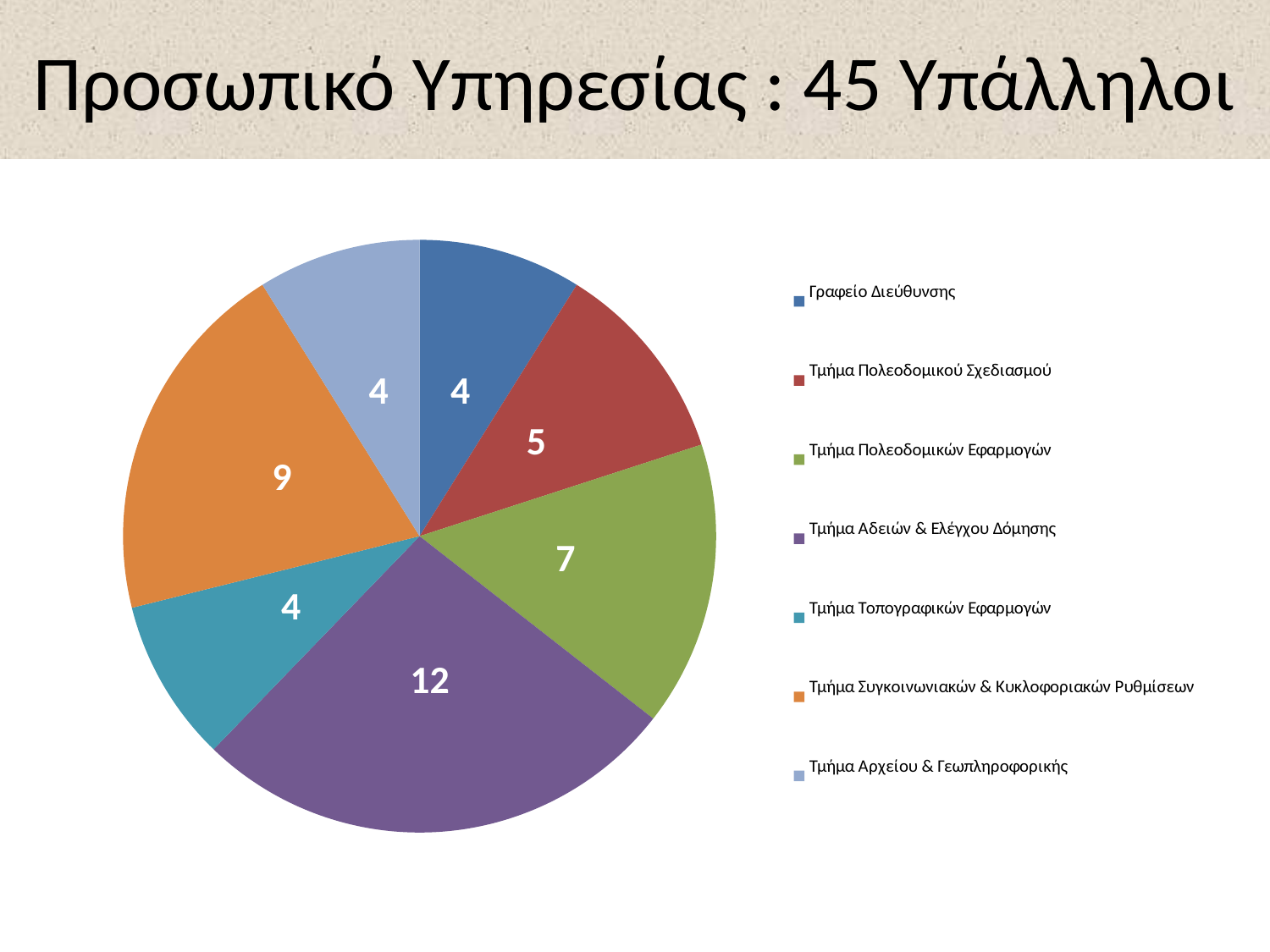
How many employees are in Τμήμα Αδειών & Ελέγχου Δόμησης? 12 What kind of chart is shown on the slide? pie chart What share of the 45 employees does Τμήμα Συγκοινωνιακών & Κυκλοφοριακών Ρυθμίσεων represent? 20% Which is larger, Τμήμα Πολεοδομικών Εφαρμογών or Τμήμα Πολεοδομικού Σχεδιασμού? Τμήμα Πολεοδομικών Εφαρμογών What is the value for Τμήμα Πολεοδομικού Σχεδιασμού? 5 Which department has the largest slice of the pie? Τμήμα Αδειών & Ελέγχου Δόμησης How many slices does the pie chart have? 7 What is the title of the slide? Προσωπικό Υπηρεσίας : 45 Υπάλληλοι What is the value for Τμήμα Συγκοινωνιακών & Κυκλοφοριακών Ρυθμίσεων? 9 What is the value for Γραφείο Διεύθυνσης? 4 What is the difference between Τμήμα Αδειών & Ελέγχου Δόμησης and Τμήμα Συγκοινωνιακών & Κυκλοφοριακών Ρυθμίσεων? 3 What is the value for Τμήμα Πολεοδομικών Εφαρμογών? 7